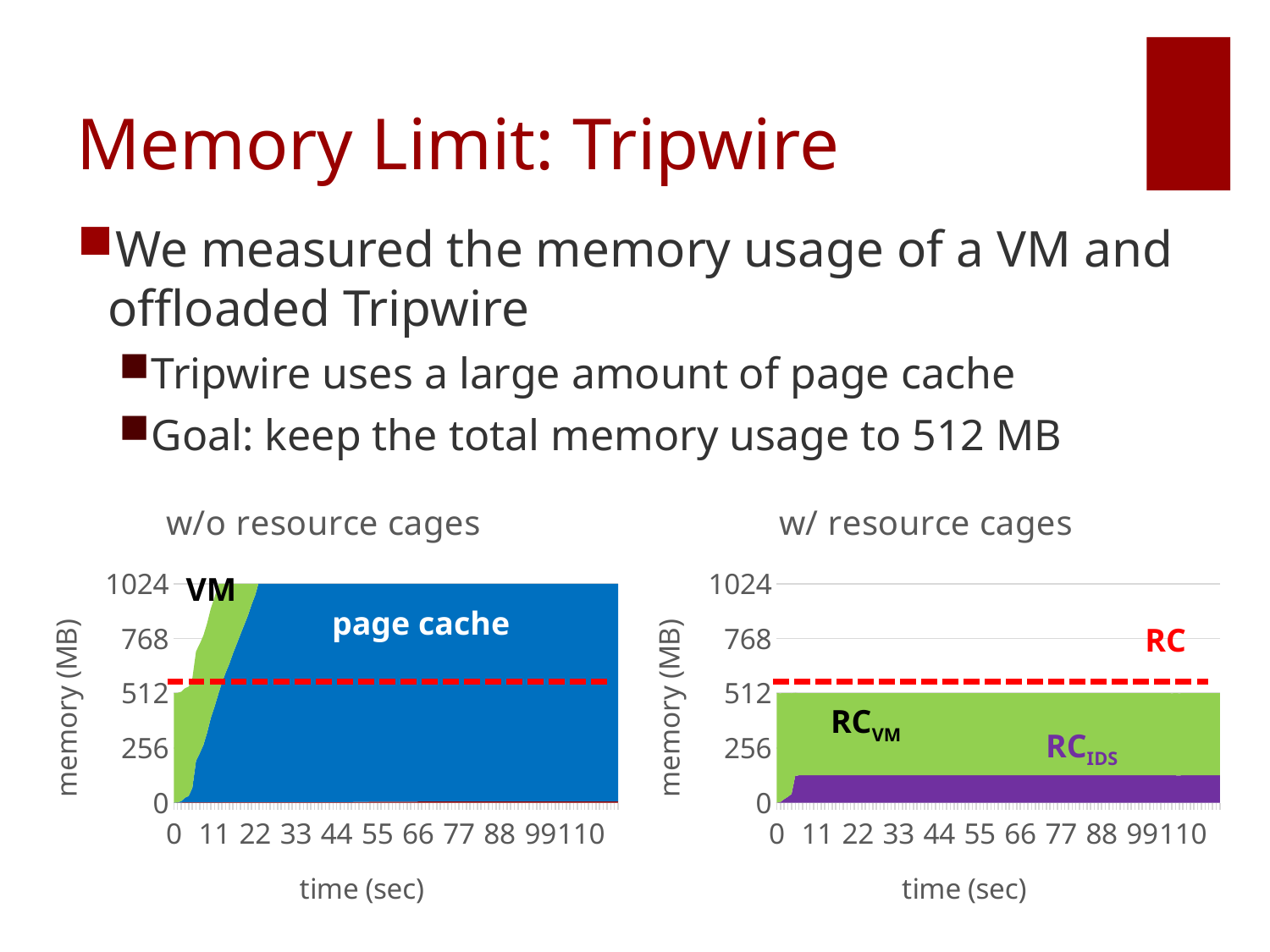
What is the x-axis label on the 'w/o resource cages' chart? time (sec) In the 'w/ resource cages' chart, is the total memory usage at 55 seconds greater or less than 768? less How many tick labels are shown on the x-axis of the 'w/ resource cages' chart? 11 In the 'w/o resource cages' chart, does the total memory usage rise or fall over the first 22 seconds? rise What kind of chart is the 'w/o resource cages' chart? stacked area chart In the 'w/o resource cages' chart, is the total memory usage at 55 seconds greater or less than 768? greater In the 'w/o resource cages' chart, which series occupies more of the area at 88 seconds, VM or page cache? page cache What is the highest tick value on the y-axis of the 'w/o resource cages' chart? 1024 In the 'w/ resource cages' chart, which series is larger at 66 seconds, RC_VM or RC_IDS? RC_VM In the 'w/ resource cages' chart, does the total memory usage rise, fall, or stay flat between 22 and 110 seconds? stay flat What is the y-axis label on the 'w/ resource cages' chart? memory (MB) In the 'w/ resource cages' chart, is the RC_IDS memory at 55 seconds greater or less than 256? less